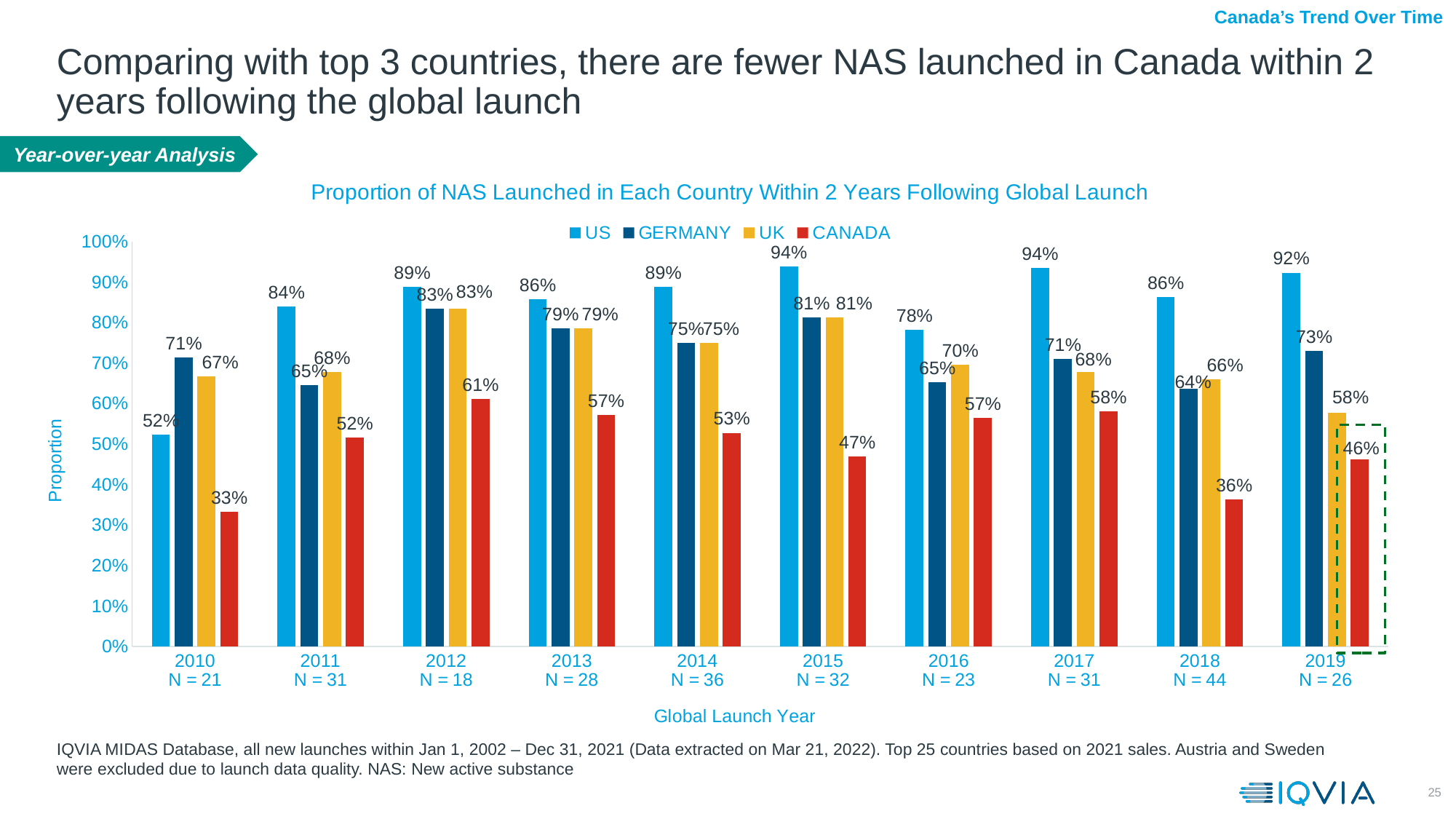
What is the difference between the US and Canada values in 2015? 47% What is the value for the UK in 2016? 70% In which year is the Canada value lowest? 2010 What kind of chart is shown on the slide? Bar chart What is the value for Canada in 2019? 46% Which country has the highest value in 2018? US What is the title of the chart? Proportion of NAS Launched in Each Country Within 2 Years Following Global Launch What is the value for Germany in 2010? 71% What is the value for the US in 2015? 94% How many series does the legend list? 4 How many global launch years are shown on the x axis? 10 Which is larger in 2010: the US value or the Germany value? Germany